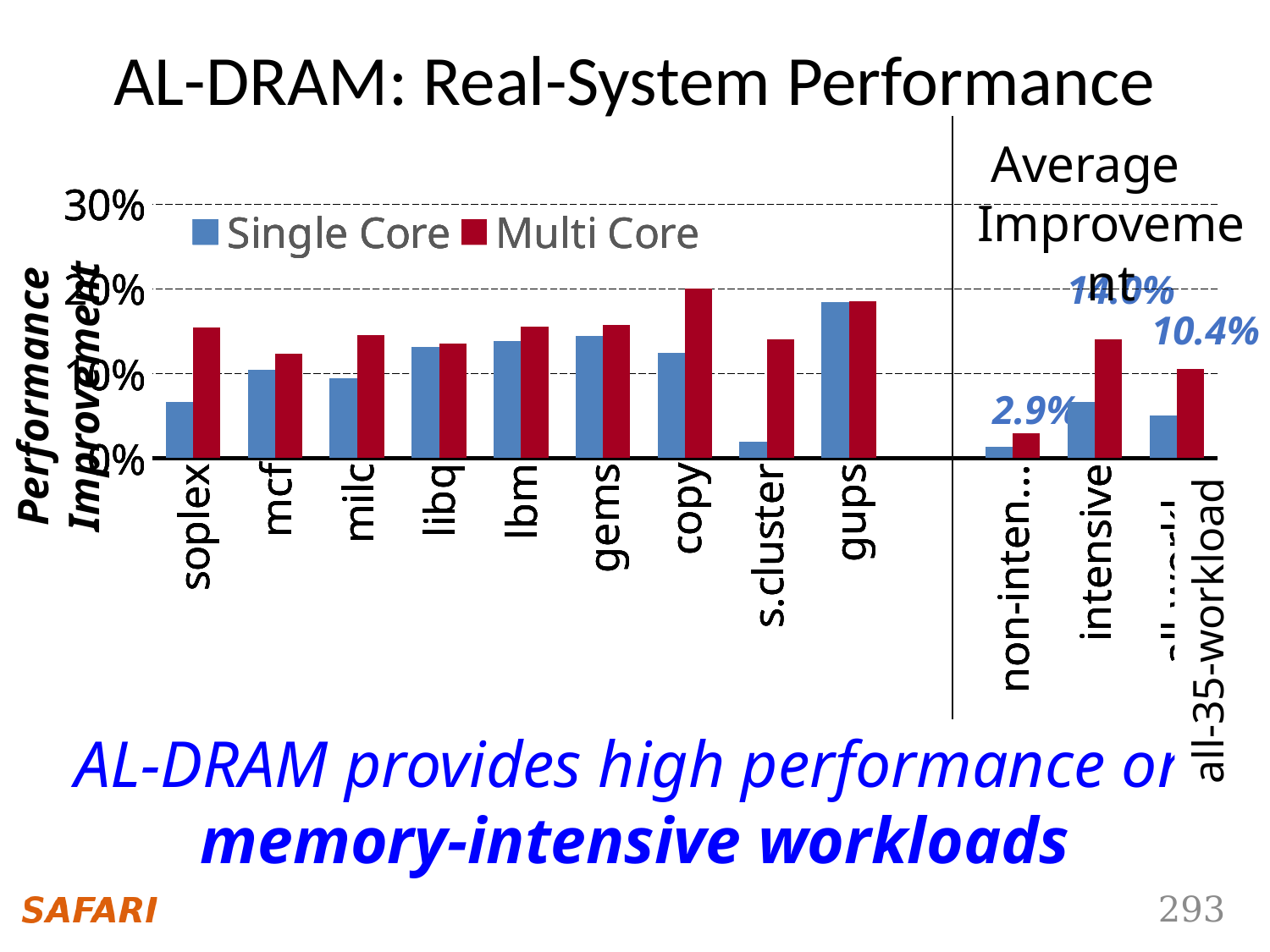
What is the labelled average Multi Core improvement for all-35-workload? 10.4% How many series does the legend list? 2 Among the nine individual benchmarks left of the divider, which has the lowest Single Core performance improvement? s.cluster Which benchmark has the highest Multi Core performance improvement? copy How many bar groups (categories) are plotted along the x axis? 12 What is the labelled average Multi Core improvement for the intensive workloads? 14.0% For s.cluster, which is larger: the Single Core or the Multi Core improvement? Multi Core What kind of chart is shown on the slide? bar chart What are the two series named in the legend? Single Core and Multi Core Is the Multi Core value for copy greater or less than 10%? greater Is the Single Core value for soplex greater or less than 10%? less Which benchmark has the highest Single Core performance improvement? gups